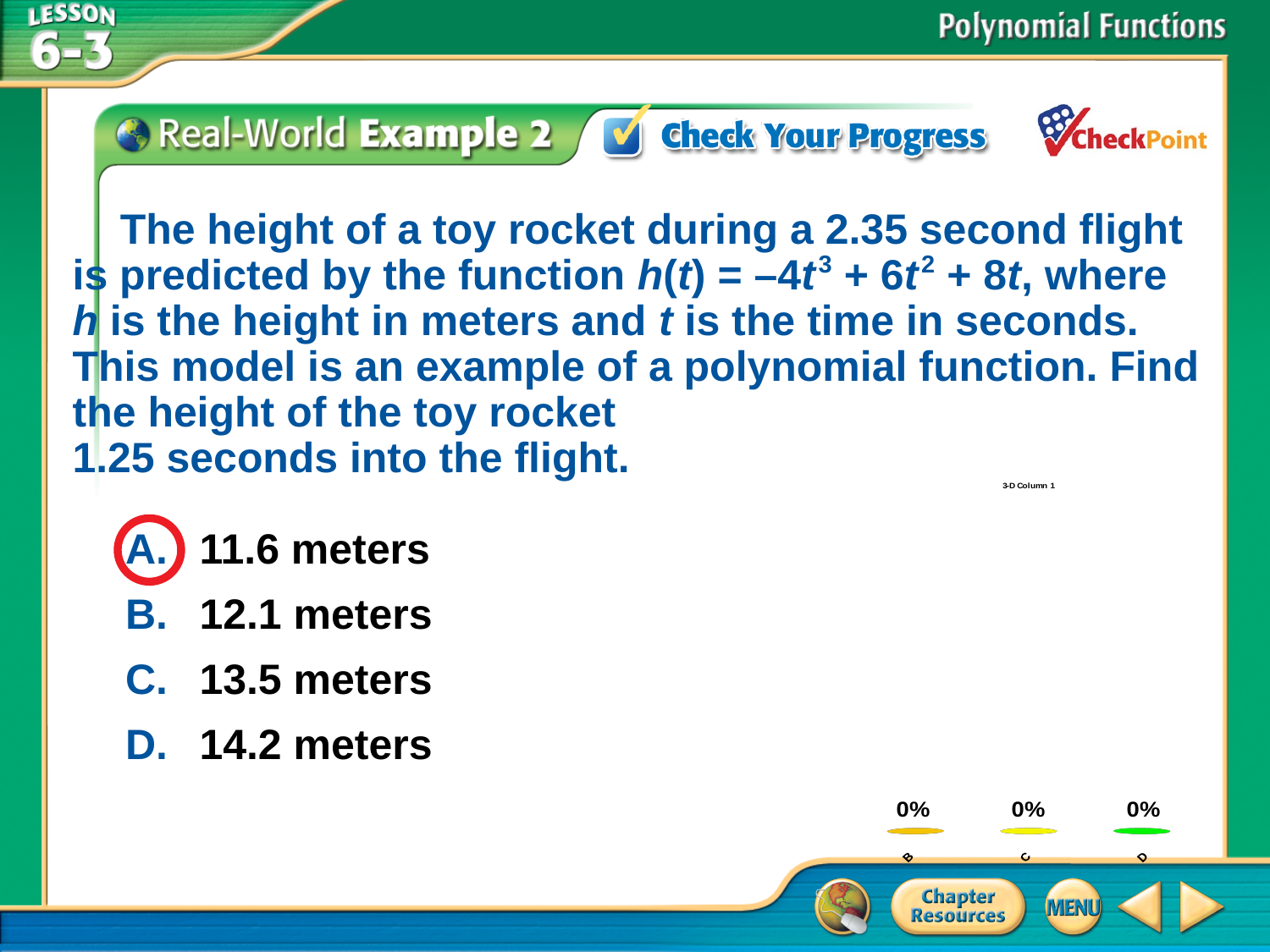
In the chart titled "3-D Column 1", is the value for C larger than the value for D, or are they equal? equal In the chart titled "3-D Column 1", do the values rise, fall, or stay the same from B to D? stay the same In the chart titled "3-D Column 1", what is the value shown for category B? 0% In the chart titled "3-D Column 1", what is the value shown for category D? 0% In the chart titled "3-D Column 1", what is the difference between the values for B and D? 0% What kind of chart is shown in the bottom right of the slide? bar chart In the chart titled "3-D Column 1", what is the value shown for category C? 0% What is the title of the chart in the bottom right of the slide? 3-D Column 1 In the chart titled "3-D Column 1", what is the total of the values shown for B, C and D? 0%